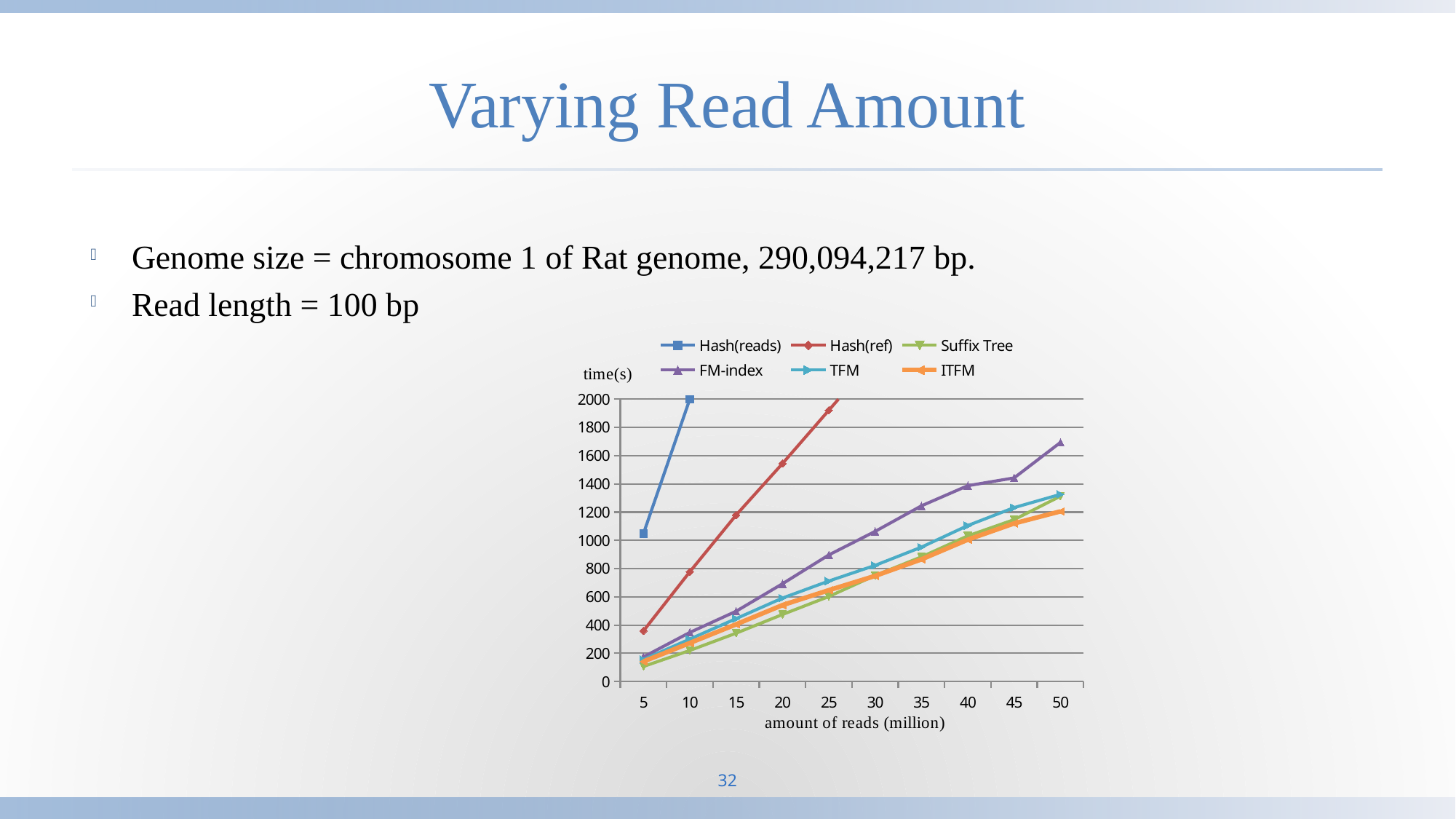
At 50 million reads, which is larger, FM-index or TFM? FM-index Is the value for FM-index at 50 million reads greater or less than 1600? greater What kind of chart is shown on the slide? line chart At 10 million reads, which is larger, Hash(reads) or Hash(ref)? Hash(reads) Does the time for FM-index rise or fall as the amount of reads increases? rise Is the value for Hash(ref) at 20 million reads greater or less than 1400? greater How many series does the legend list? 6 Is the value for Suffix Tree at 5 million reads greater or less than 200? less What is the label of the x axis? amount of reads (million) How many values of amount of reads are marked on the x axis? 10